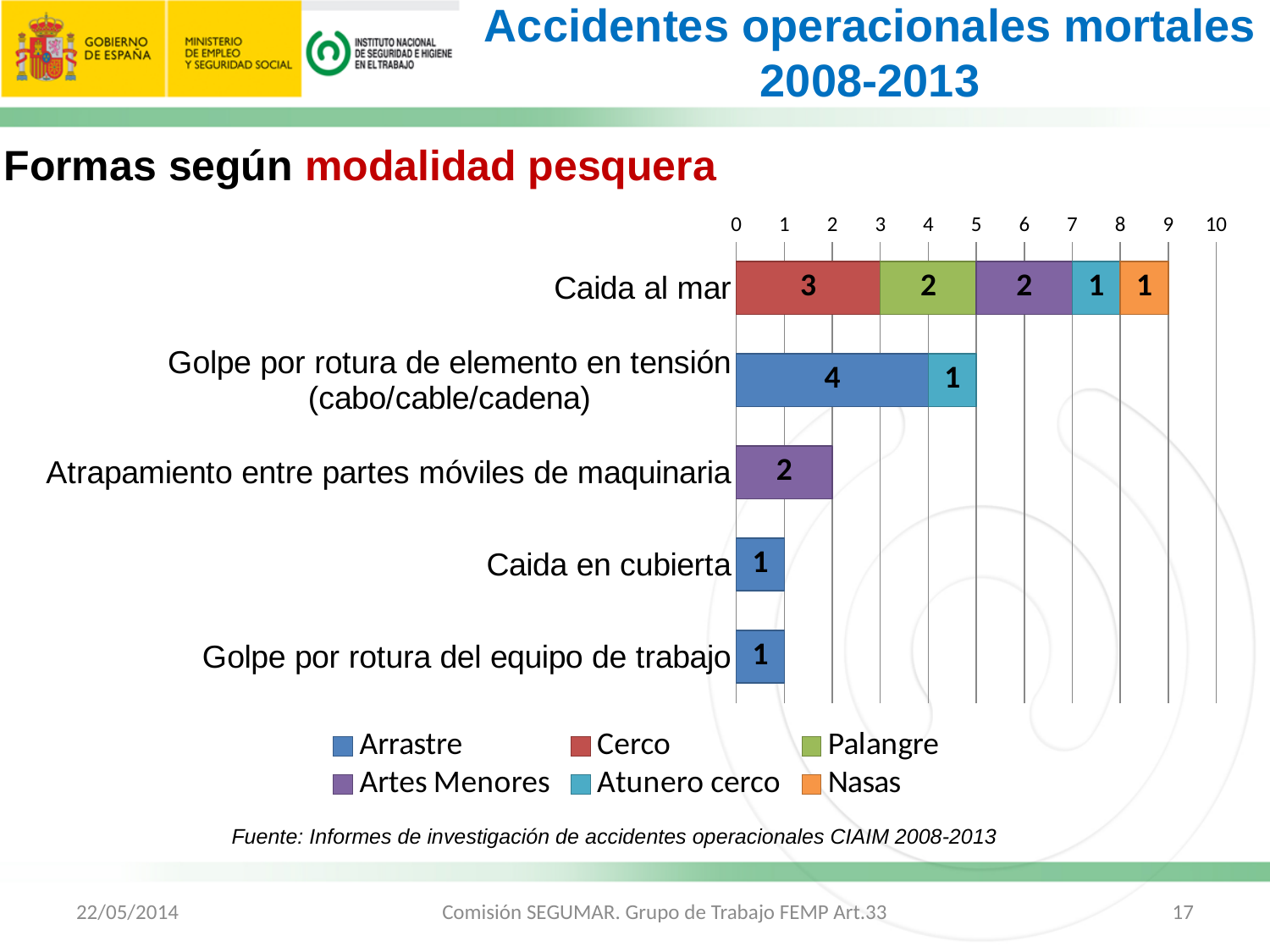
What is the total of the stacked bar for 'Caida al mar'? 9 What is the difference between the Cerco value and the Palangre value in the 'Caida al mar' bar? 1 What is the value for Cerco in the 'Caida al mar' bar? 3 What type of chart is shown on the slide? stacked bar chart Which legend entry is shown in orange? Nasas How many accident categories are plotted on the chart? 5 What is the total of the stacked bar for 'Golpe por rotura de elemento en tensión (cabo/cable/cadena)'? 5 Which category has the highest total? Caida al mar What is the value for Artes Menores in the 'Atrapamiento entre partes móviles de maquinaria' bar? 2 What is the value for Arrastre in the 'Golpe por rotura de elemento en tensión (cabo/cable/cadena)' bar? 4 How many series does the legend list? 6 Which is larger: the Arrastre value for 'Golpe por rotura de elemento en tensión (cabo/cable/cadena)' or the Artes Menores value for 'Atrapamiento entre partes móviles de maquinaria'? Arrastre value for 'Golpe por rotura de elemento en tensión (cabo/cable/cadena)'